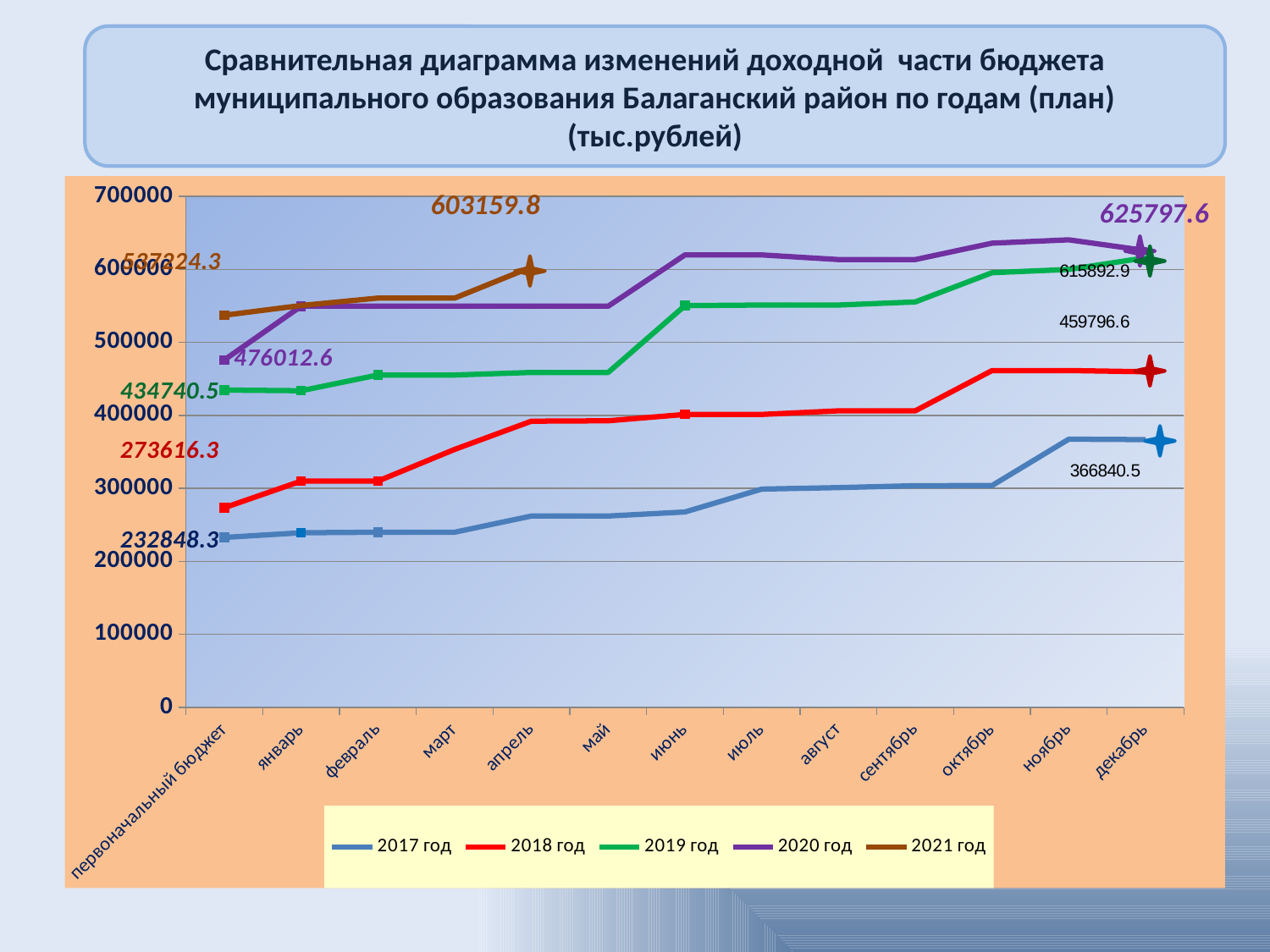
What is the value for 2017 год in декабрь? 366840.5 Is the value for 2019 год in июнь greater or less than 500000? greater Which series has the highest value in декабрь? 2020 год What kind of chart is shown on the slide? line chart How many categories are shown along the x axis? 13 What is the value for 2021 год in апрель? 603159.8 What is the value for 2018 год in декабрь? 459796.6 What is the value for 2017 год at первоначальный бюджет? 232848.3 What is the value for 2020 год in декабрь? 625797.6 What is the difference between the 2020 год and 2019 год values in декабрь? 9904.7 How many series does the legend list? 5 Which series has the lowest value in декабрь? 2017 год